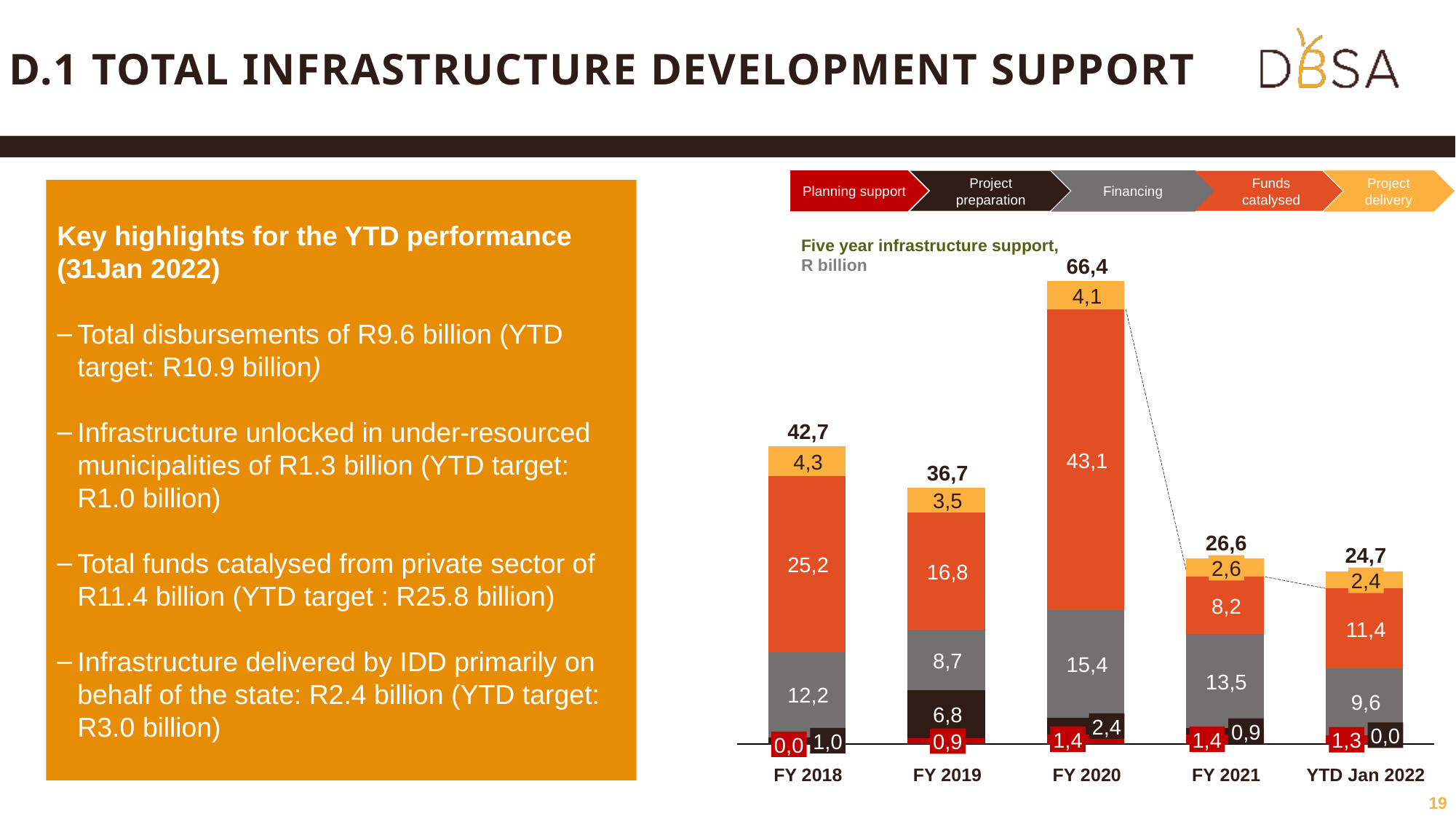
What unit is stated in the chart's subtitle? R billion How many periods are shown on the x axis of the chart? 5 What is the Project delivery value for YTD Jan 2022? 2,4 Which is larger, the Financing value for FY 2019 or the Financing value for YTD Jan 2022? YTD Jan 2022 What is the total infrastructure support for FY 2020? 66,4 What is the Funds catalysed value for FY 2018? 25,2 What type of chart is shown on the slide? Stacked bar chart Which period has the lowest total infrastructure support? YTD Jan 2022 How many series does the legend above the chart list? 5 Which year has the highest total infrastructure support? FY 2020 What is the Financing value for FY 2021? 13,5 What is the difference between the total for FY 2018 and the total for FY 2019? 6,0